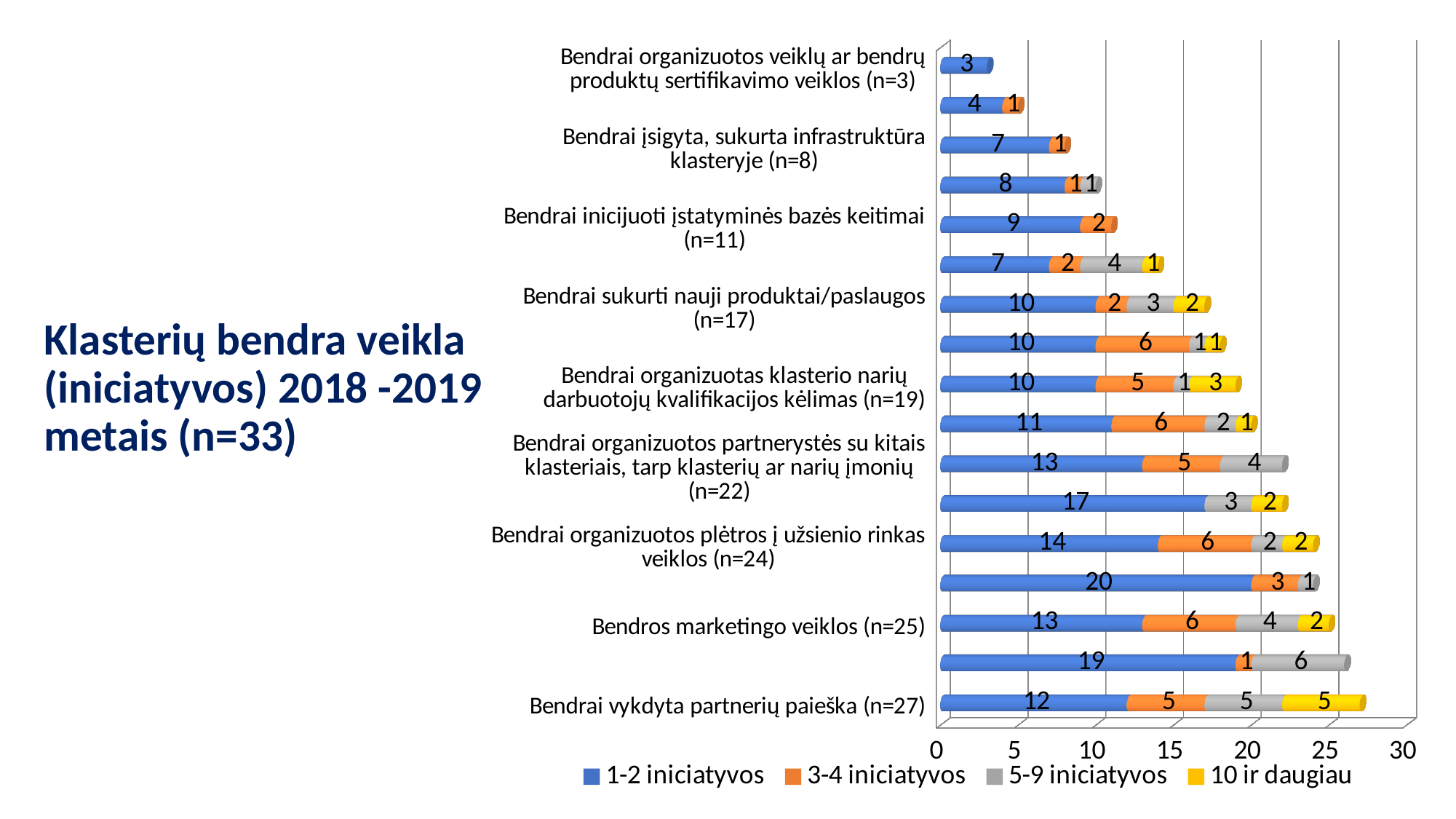
What is the total of the stacked bar for 'Bendrai sukurti nauji produktai/paslaugos (n=17)'? 17 Which category has the shortest total bar? Bendrai organizuotos veiklų ar bendrų produktų sertifikavimo veiklos (n=3) What is the value of the '5-9 iniciatyvos' series for 'Bendrai organizuotas klasterio narių darbuotojų kvalifikacijos kėlimas (n=19)'? 1 Which category has the longest total bar? Bendrai vykdyta partnerių paieška (n=27) What is the value of the '3-4 iniciatyvos' series for 'Bendrai organizuotos plėtros į užsienio rinkas veiklos (n=24)'? 6 What is the value of the '1-2 iniciatyvos' series for 'Bendrai vykdyta partnerių paieška (n=27)'? 12 What kind of chart is shown on the slide? Stacked bar chart How many series does the legend list? 4 What is the difference between the '1-2 iniciatyvos' values for 'Bendros marketingo veiklos (n=25)' and 'Bendrai vykdyta partnerių paieška (n=27)'? 1 Which has a larger '1-2 iniciatyvos' value: 'Bendrai organizuotos plėtros į užsienio rinkas veiklos (n=24)' or 'Bendrai organizuotas klasterio narių darbuotojų kvalifikacijos kėlimas (n=19)'? Bendrai organizuotos plėtros į užsienio rinkas veiklos (n=24) Is the total bar length for 'Bendrai inicijuoti įstatyminės bazės keitimai (n=11)' greater or less than 15? less What is the value of the '10 ir daugiau' series for 'Bendros marketingo veiklos (n=25)'? 2